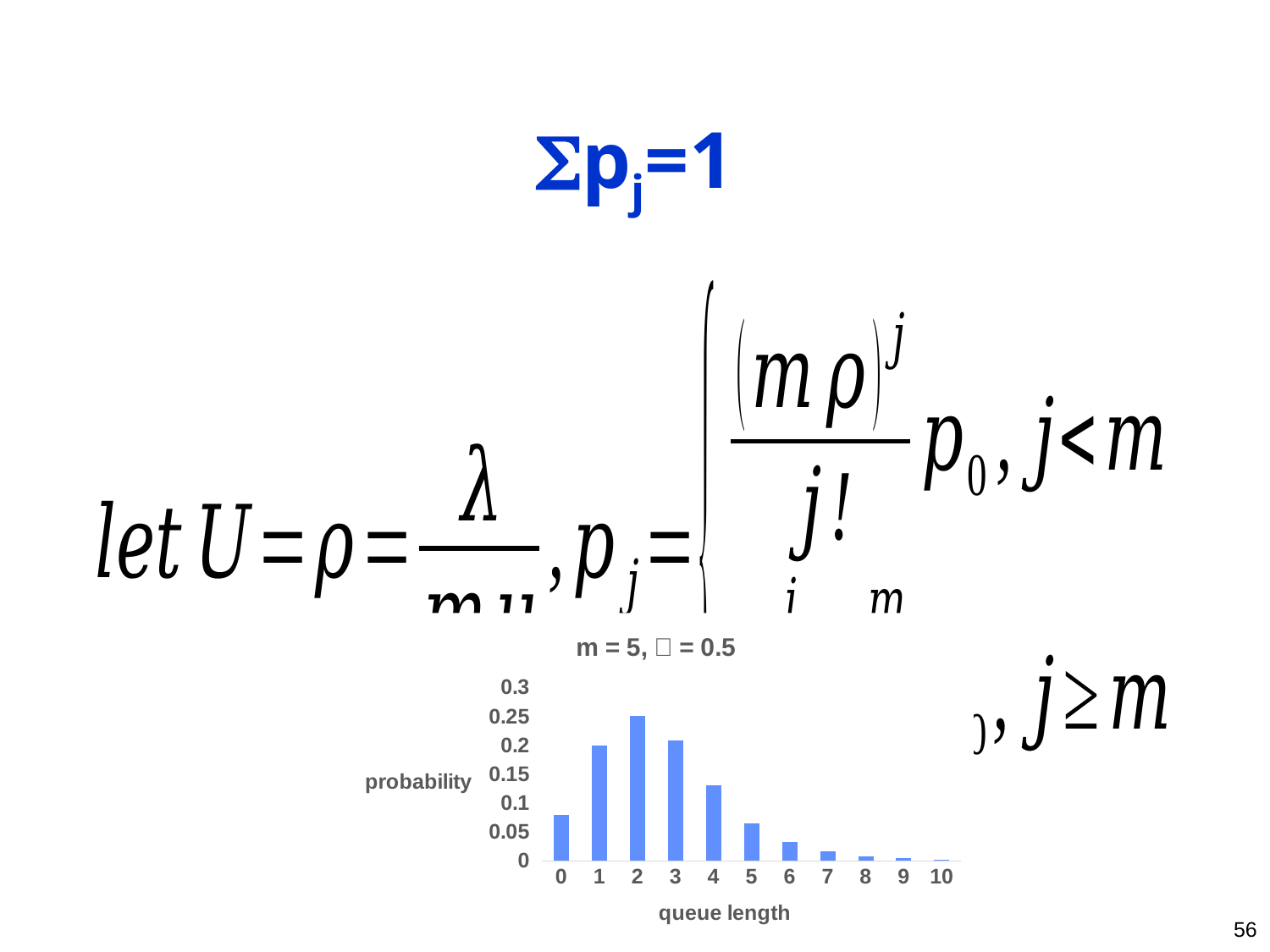
What kind of chart is shown on the slide? bar chart Is the probability for queue length 0 greater or less than 0.1? less What is the label on the y axis of the chart? probability Which queue length has the highest probability in the chart? 2 Which has the higher probability, queue length 1 or queue length 4? queue length 1 Which has the higher probability, queue length 3 or queue length 5? queue length 3 Is the probability for queue length 5 greater or less than 0.1? less Is the probability for queue length 2 greater or less than 0.2? greater Do the probabilities rise or fall as queue length increases from 2 to 10? fall What is the label on the x axis of the chart? queue length How many queue length categories are plotted on the x axis of the chart? 11